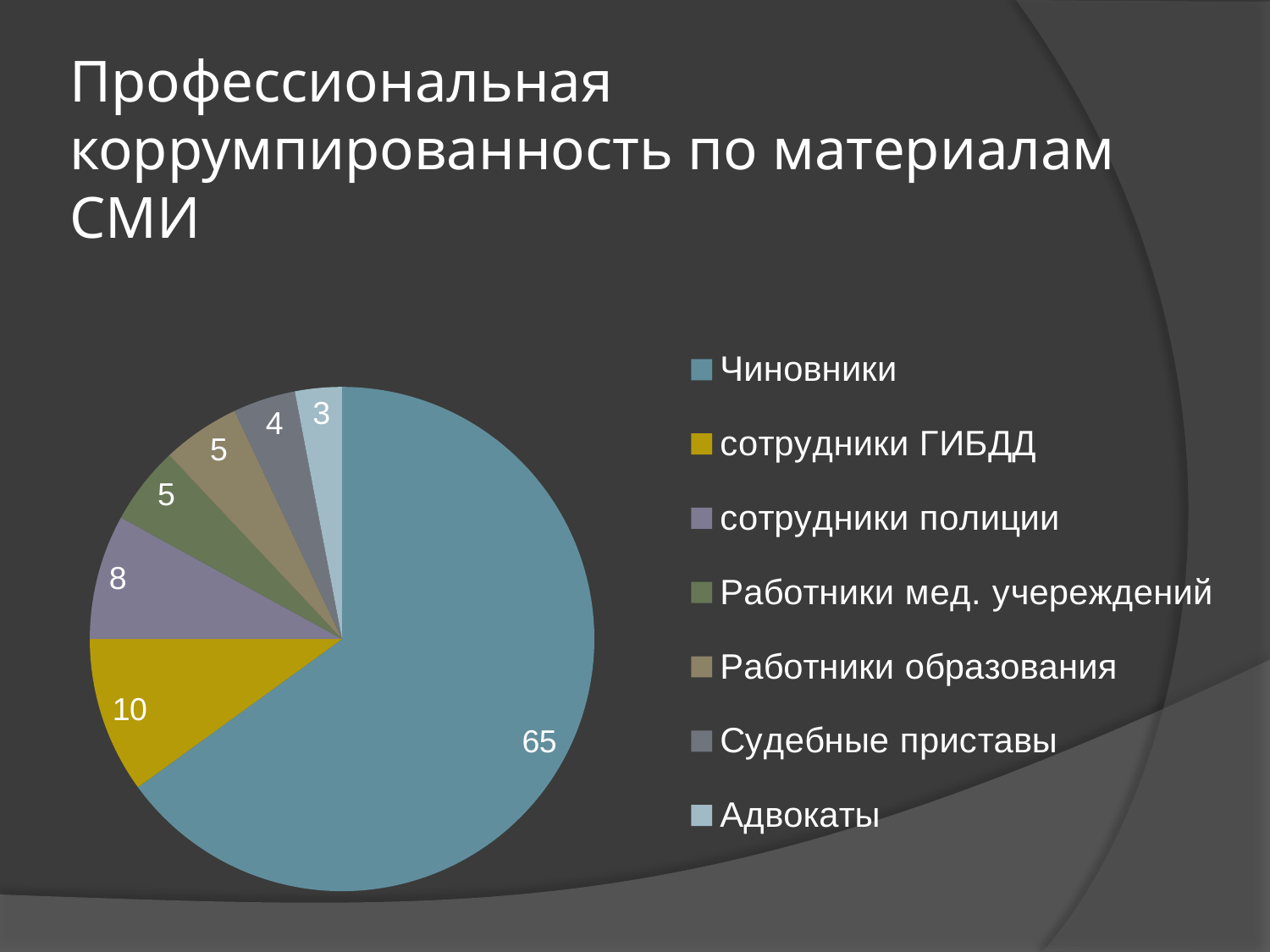
What share of the pie does the Чиновники slice represent? 65% Which category has the smallest slice of the pie? Адвокаты Which category has the largest slice of the pie? Чиновники What is the value for Чиновники? 65 What is the value for Судебные приставы? 4 What is the value for сотрудники полиции? 8 How many categories does the pie chart have? 7 Which is larger, the value for сотрудники полиции or the value for Судебные приставы? сотрудники полиции What kind of chart is shown on the slide? pie chart What is the value for Адвокаты? 3 What is the difference between the values for Чиновники and сотрудники ГИБДД? 55 What is the value for сотрудники ГИБДД? 10